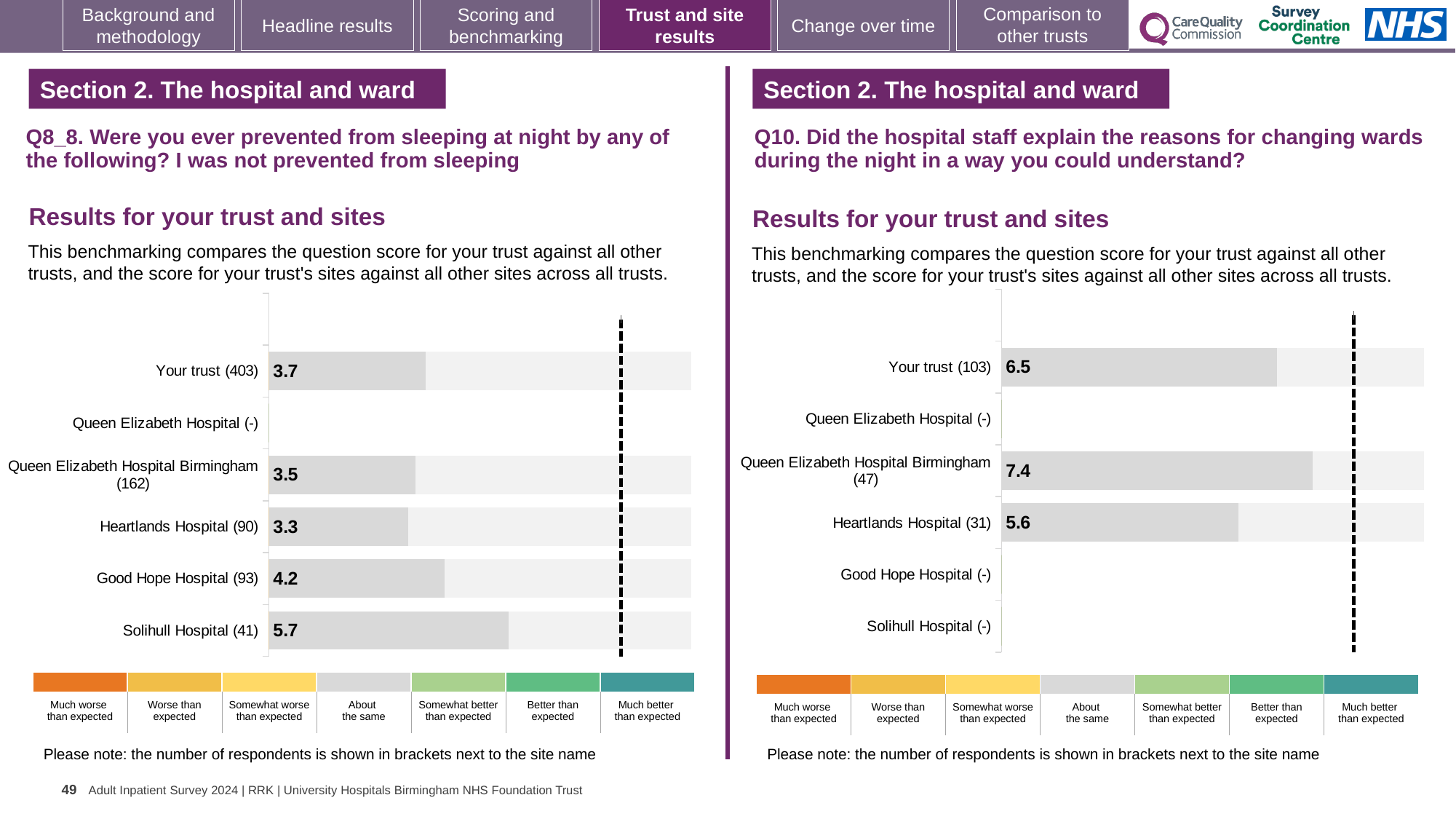
How many site rows (including Your trust) are listed in the Q10 chart on the right? 6 In the Q8_8 chart on the left, which has the higher score, Good Hope Hospital or Queen Elizabeth Hospital Birmingham? Good Hope Hospital In the Q10 chart on the right, what is the score for Queen Elizabeth Hospital Birmingham? 7.4 In the Q8_8 chart on the left, what is the difference between the scores for Solihull Hospital and Heartlands Hospital? 2.4 In the Q10 chart on the right, what is the score for Heartlands Hospital? 5.6 In the Q8_8 chart on the left, what is the score for Your trust? 3.7 In the Q8_8 chart on the left, what is the score for Solihull Hospital? 5.7 In the Q8_8 chart on the left, which site has the highest score? Solihull Hospital In the Q10 chart on the right, what is the difference between the scores for Queen Elizabeth Hospital Birmingham and Your trust? 0.9 In the Q8_8 chart on the left, which site with a plotted score has the lowest score? Heartlands Hospital In the Q10 chart on the right, which has the higher score, Your trust or Heartlands Hospital? Your trust What kind of chart is used in the Q8_8 chart on the left? Bar chart